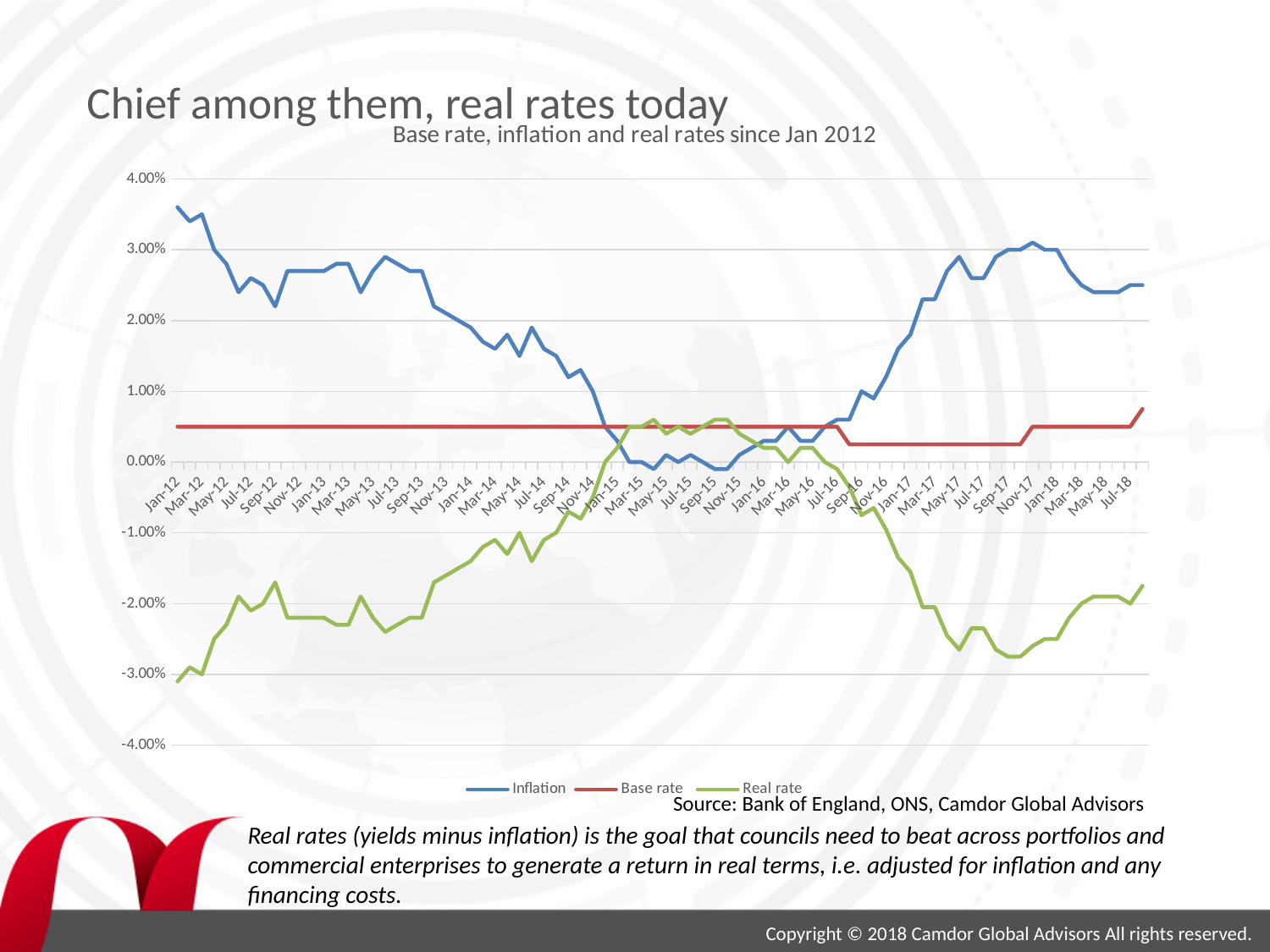
Is the Inflation value for Sep-15 greater or less than 1.00%? less Does the Inflation line rise or fall between Jan-12 and Sep-15? fall Is the Inflation value for Jul-18 greater or less than 2.00%? greater What is the title of the chart? Base rate, inflation and real rates since Jan 2012 Is the Real rate value for Sep-17 greater or less than -2.00%? less Does the Inflation line rise or fall between Jan-16 and Nov-17? rise What kind of chart is shown on the slide? line chart Which is larger in Jan-12, the Inflation value or the Real rate value? Inflation What are the three series listed in the chart's legend? Inflation, Base rate, Real rate How many series does the chart's legend list? 3